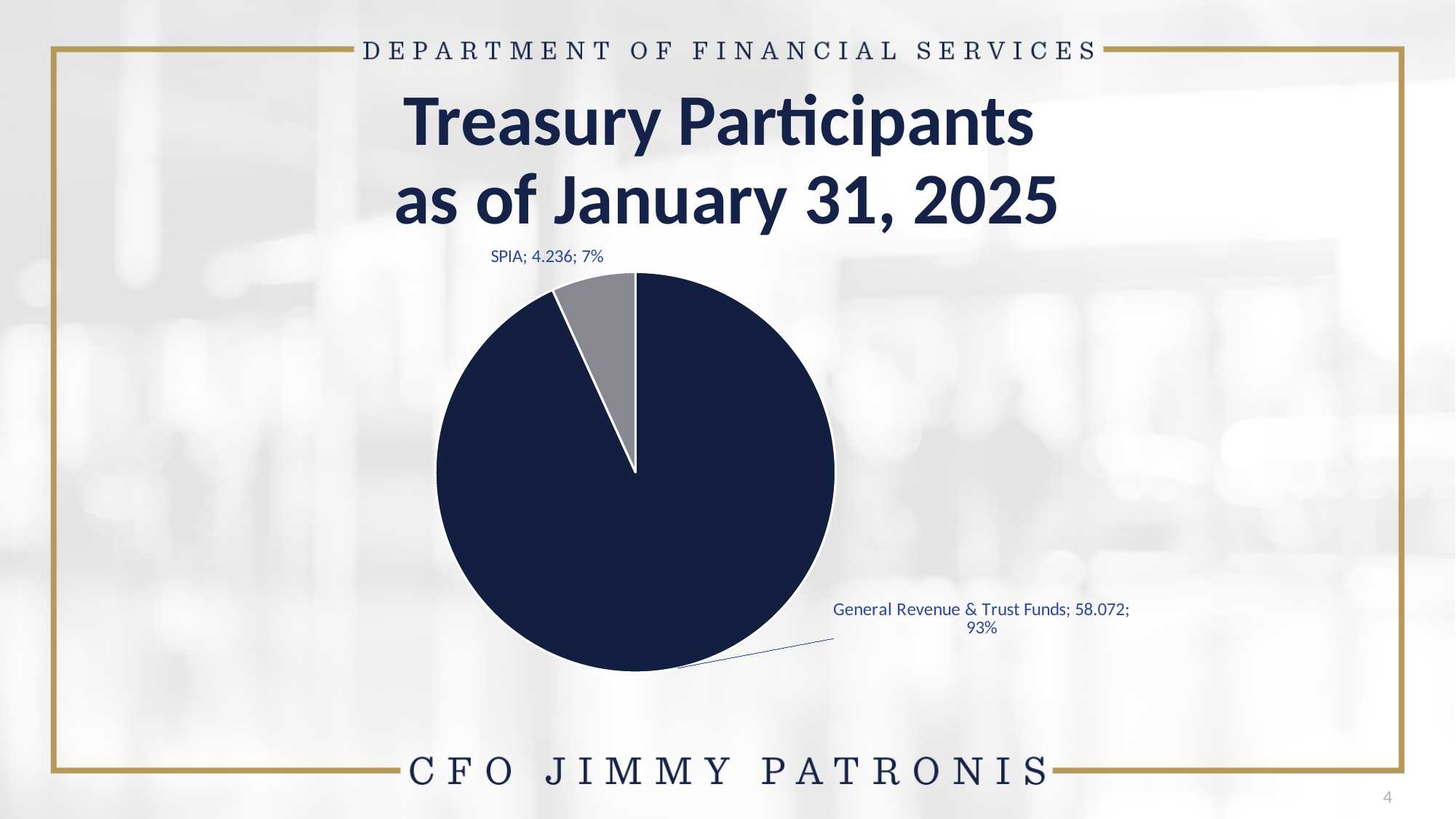
Which slice is the smallest in the pie chart? SPIA What percentage share of the pie does SPIA represent? 7% What is the difference between the values for General Revenue & Trust Funds and SPIA? 53.836 What colour is the SPIA slice of the pie chart? grey How many slices does the pie chart have? 2 What percentage share of the pie does General Revenue & Trust Funds represent? 93% Which is larger, the value for SPIA or the value for General Revenue & Trust Funds? General Revenue & Trust Funds What is the title of the chart on the slide? Treasury Participants as of January 31, 2025 What is the value shown for SPIA? 4.236 Which slice is the largest in the pie chart? General Revenue & Trust Funds What type of chart is shown on the slide? pie chart What is the value shown for General Revenue & Trust Funds? 58.072